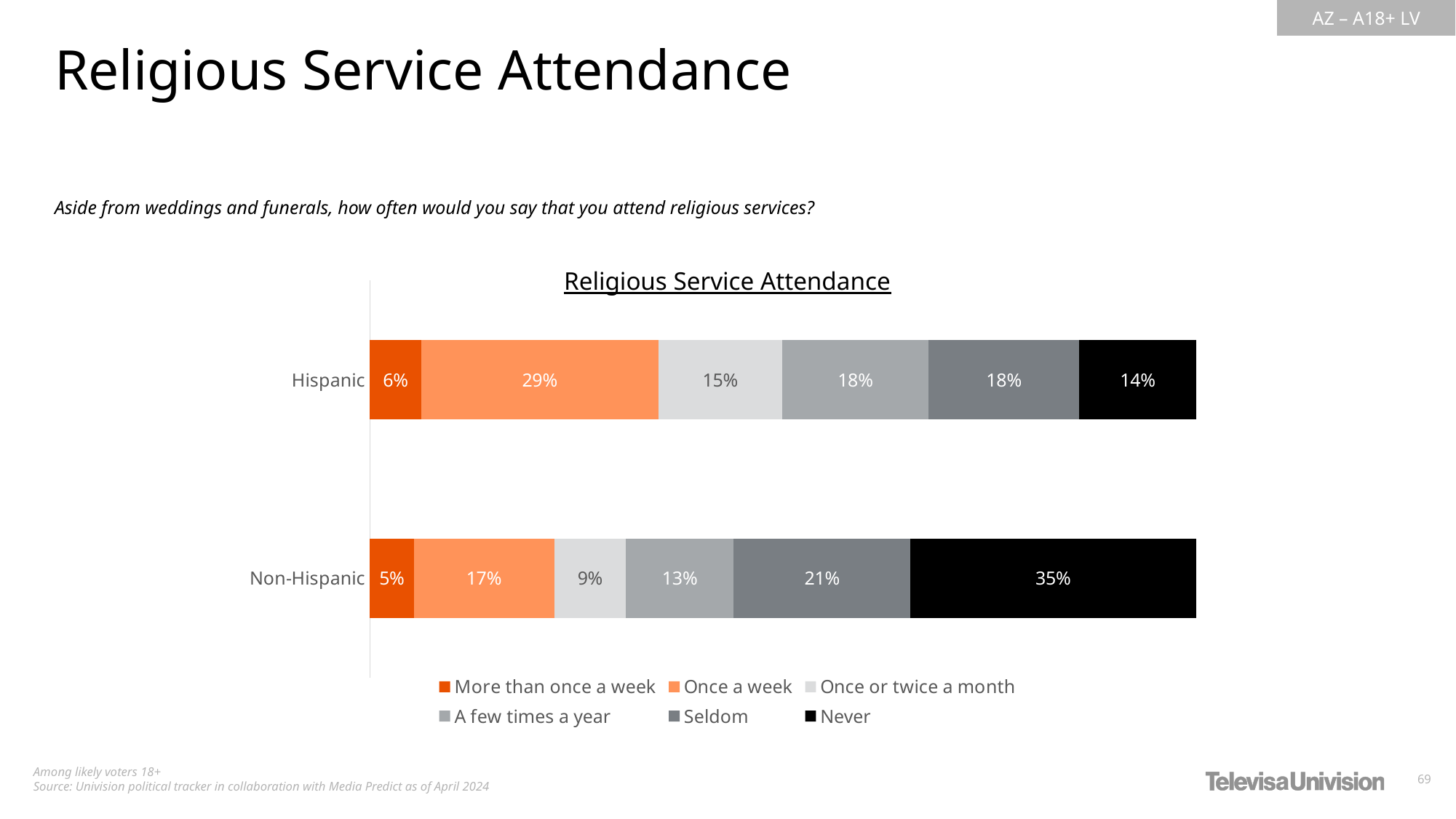
What kind of chart is shown on the slide? Stacked bar chart Which response has the lowest share among Non-Hispanic respondents? More than once a week What percentage of Non-Hispanic respondents say they never attend religious services? 35% What percentage of Hispanic respondents attend religious services more than once a week? 6% What percentage of Hispanic respondents attend religious services once a week? 29% How many series does the legend list? 6 What is the difference between the Hispanic and Non-Hispanic shares for 'Once a week'? 12% Which response has the highest share among Hispanic respondents? Once a week Which category has the larger share of respondents who never attend religious services, Hispanic or Non-Hispanic? Non-Hispanic What percentage of Non-Hispanic respondents attend religious services once or twice a month? 9% How many categories (bars) are shown in the chart? 2 What is the difference between the Non-Hispanic and Hispanic shares for 'Never'? 21%